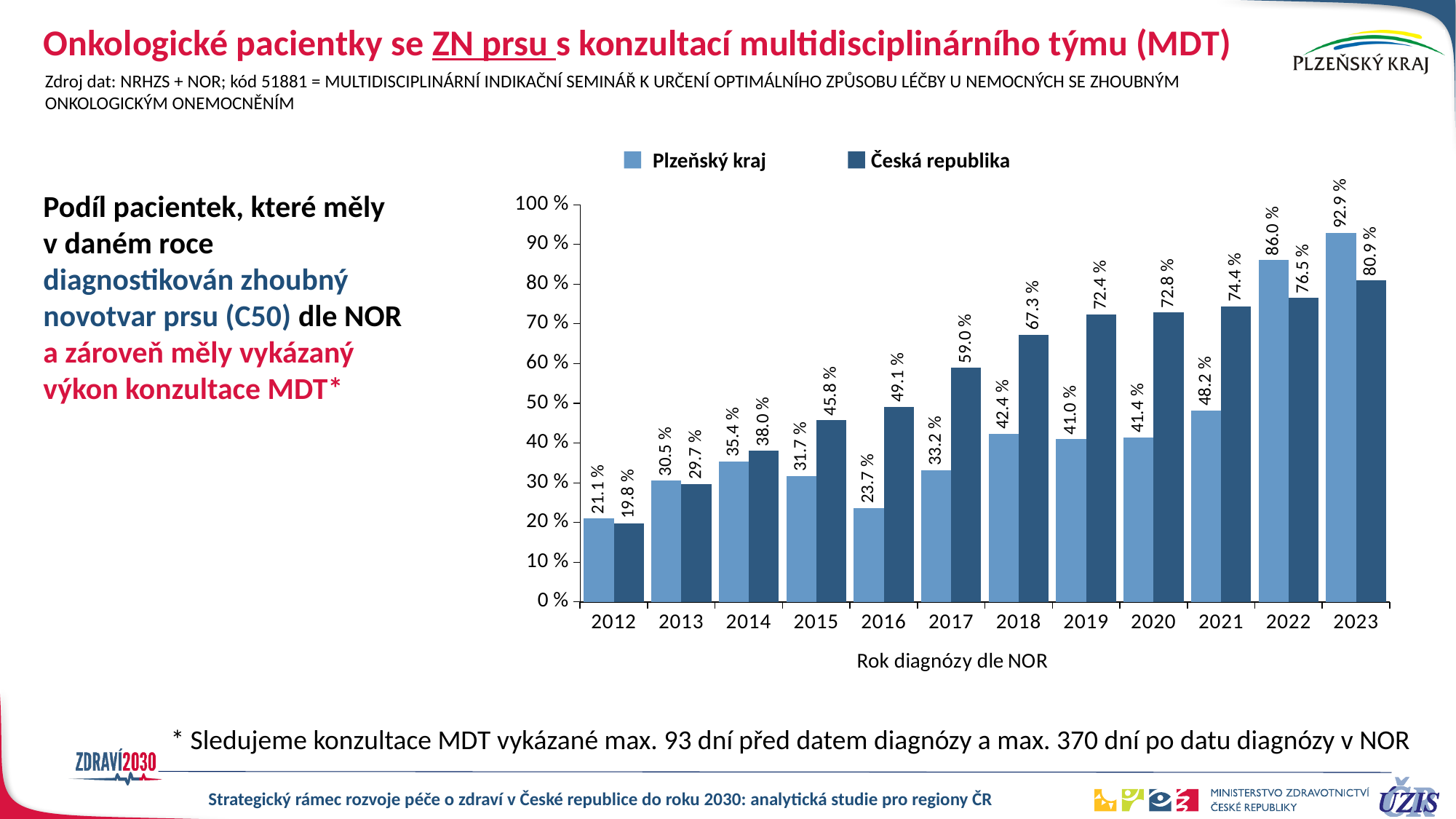
In which year is the value for Plzeňský kraj lowest? 2012 How many series does the legend list? 2 What is the value for Plzeňský kraj in 2023? 92.9 % What is the value for Plzeňský kraj in 2016? 23.7 % Which is larger in 2017, Plzeňský kraj or Česká republika? Česká republika How many years are shown on the x axis? 12 What kind of chart is shown on the slide? Bar chart Do the values for Česká republika rise or fall from 2012 to 2023? Rise What is the value for Česká republika in 2018? 67.3 % What is the difference between Česká republika and Plzeňský kraj in 2019? 31.4 % In which year is the value for Česká republika highest? 2023 Which is larger in 2022, Plzeňský kraj or Česká republika? Plzeňský kraj